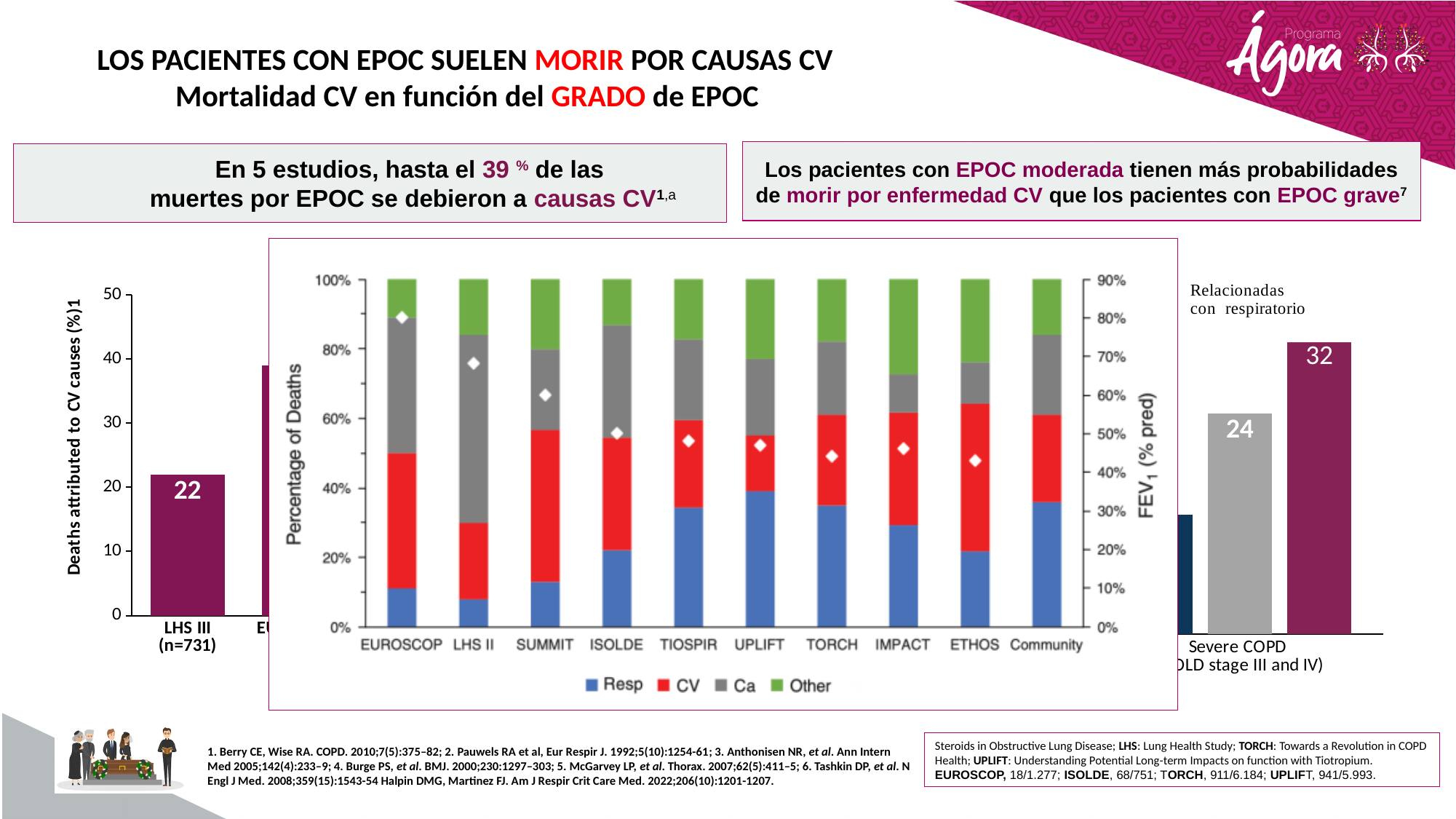
In the central 'Percentage of Deaths' chart, how many studies are shown along the x axis? 10 In the central 'Percentage of Deaths' chart, how many entries does the legend list? 4 In the central 'Percentage of Deaths' chart, which study has the highest FEV1 (% pred) diamond marker? EUROSCOP In the left chart 'Deaths attributed to CV causes (%)', what is the value for LHS III (n=731)? 22 In the central 'Percentage of Deaths' chart, is the FEV1 (% pred) value for ETHOS greater or less than 50%? less In the central 'Percentage of Deaths' chart, is the Resp share for EUROSCOP greater or less than 20%? less In the central 'Percentage of Deaths' chart, is the FEV1 (% pred) value for EUROSCOP greater or less than 70%? greater In the central 'Percentage of Deaths' chart, which colour represents CV deaths? red What kind of chart is the central chart titled with the y axis 'Percentage of Deaths'? stacked bar chart In the central 'Percentage of Deaths' chart, which study has a larger Resp segment, EUROSCOP or UPLIFT? UPLIFT In the right chart, what is the difference between the bar labelled 32 and the bar labelled 24? 8